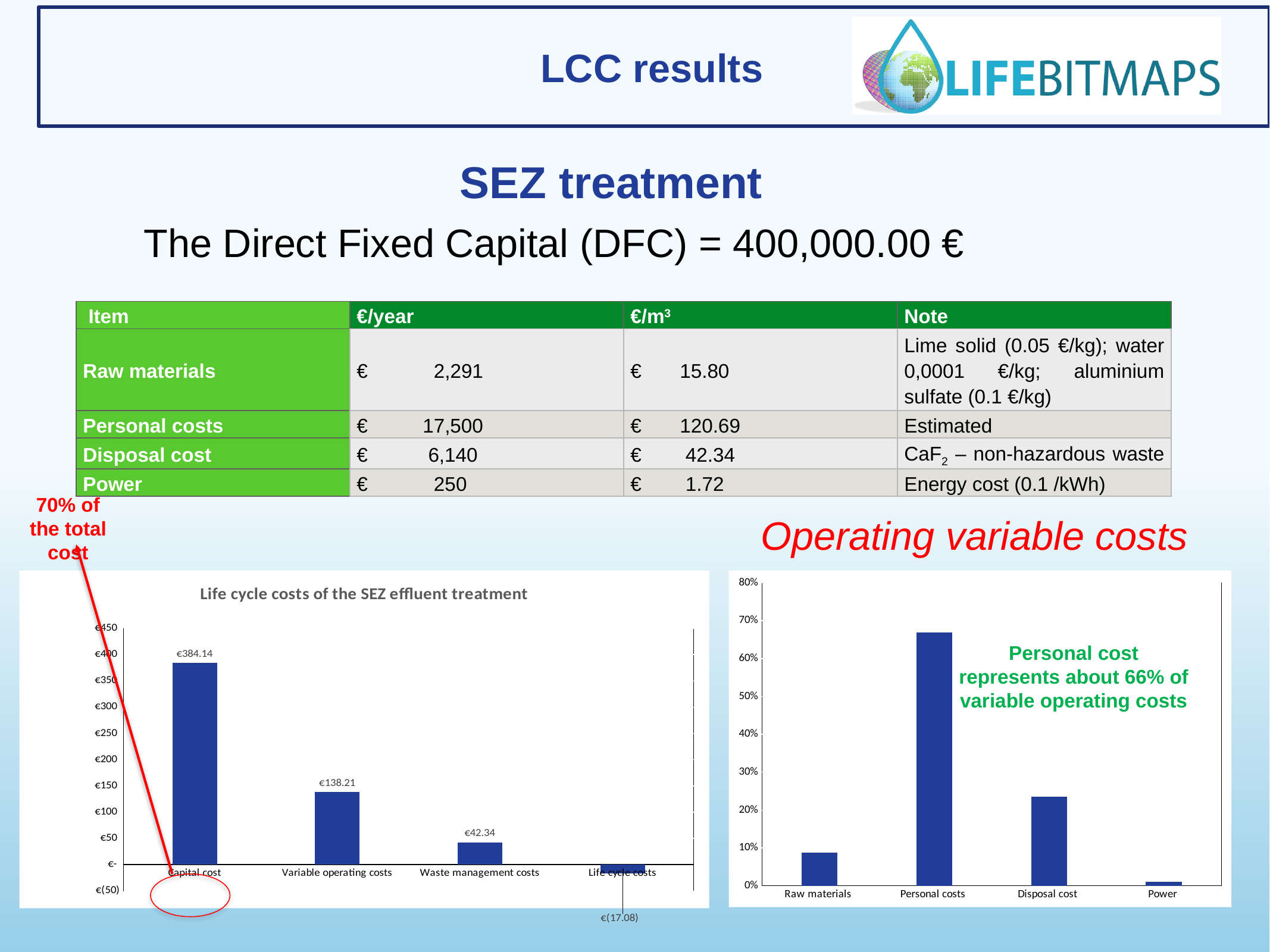
In the chart titled 'Life cycle costs of the SEZ effluent treatment', what is the value for Variable operating costs? €138.21 In the chart titled 'Life cycle costs of the SEZ effluent treatment', which category has the highest value? Capital cost What kind of chart is the 'Life cycle costs of the SEZ effluent treatment' chart? Bar chart In the Operating variable costs chart on the right, which category has the lowest value? Power In the chart titled 'Life cycle costs of the SEZ effluent treatment', what is the difference between Capital cost and Variable operating costs? €245.93 In the Operating variable costs chart on the right, is the value for Disposal cost greater or less than 20%? greater In the Operating variable costs chart on the right, which category has the highest value? Personal costs In the chart titled 'Life cycle costs of the SEZ effluent treatment', what is the value for Capital cost? €384.14 In the chart titled 'Life cycle costs of the SEZ effluent treatment', what is the value for Waste management costs? €42.34 In the Operating variable costs chart on the right, is the value for Raw materials greater or less than 10%? less In the chart titled 'Life cycle costs of the SEZ effluent treatment', how many categories are shown on the x axis? 4 In the chart titled 'Life cycle costs of the SEZ effluent treatment', what is the value labelled for Life cycle costs? €(17.08)